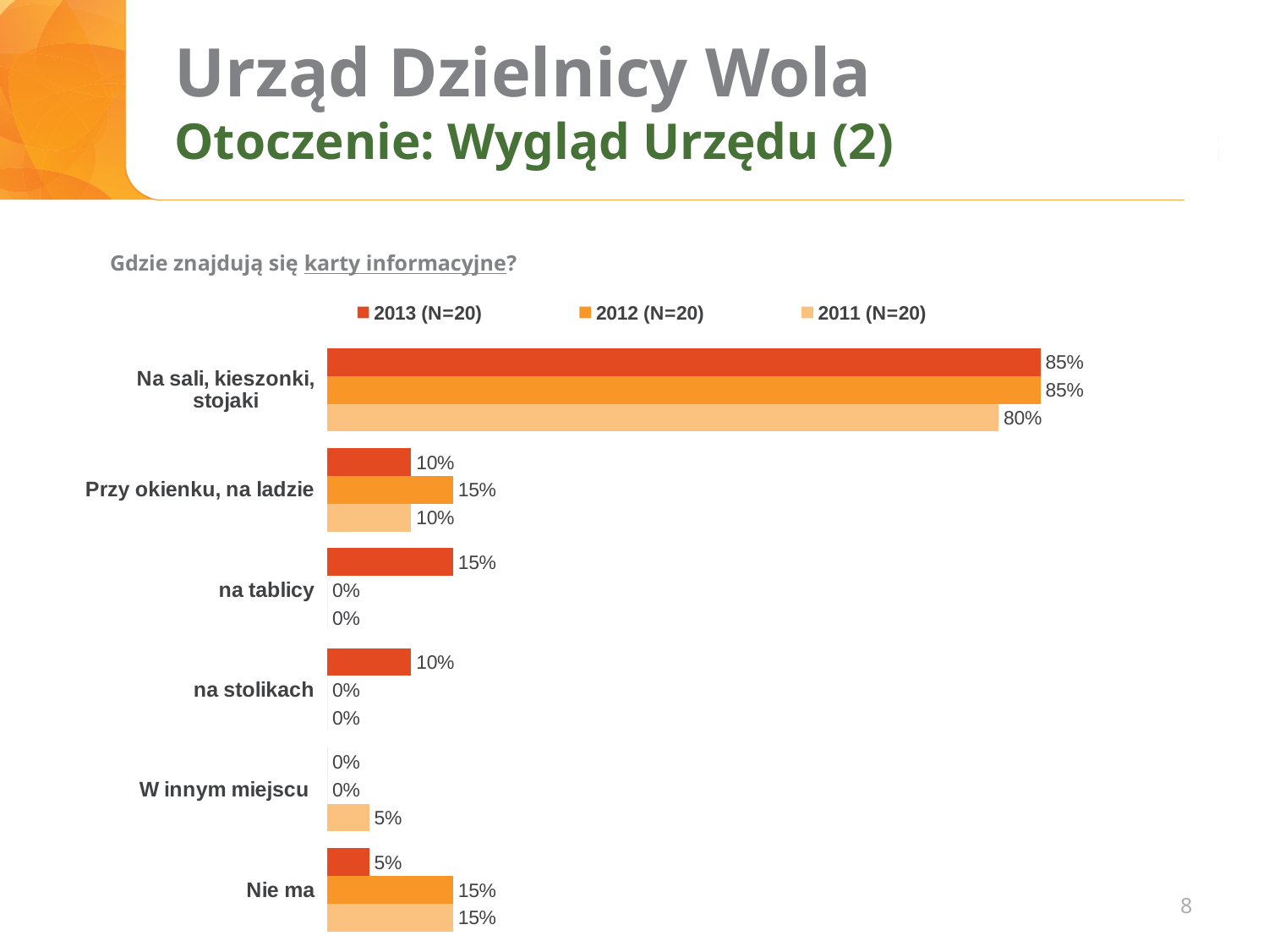
What is the value for 'na tablicy' in the 2013 (N=20) series? 15% Which is larger for 'Nie ma': the 2013 (N=20) value or the 2012 (N=20) value? 2012 (N=20) Which category has the highest value in the 2012 (N=20) series? Na sali, kieszonki, stojaki What is the value for 'Na sali, kieszonki, stojaki' in the 2013 (N=20) series? 85% What is the value for 'Przy okienku, na ladzie' in the 2012 (N=20) series? 15% How many series does the legend list? 3 What is the difference between the 2013 (N=20) and 2011 (N=20) values for 'Na sali, kieszonki, stojaki'? 5% How many categories are shown on the chart? 6 What is the value for 'W innym miejscu' in the 2011 (N=20) series? 5% What is the value for 'Na sali, kieszonki, stojaki' in the 2011 (N=20) series? 80% What kind of chart is shown on the slide? Bar chart What is the value for 'Nie ma' in the 2013 (N=20) series? 5%